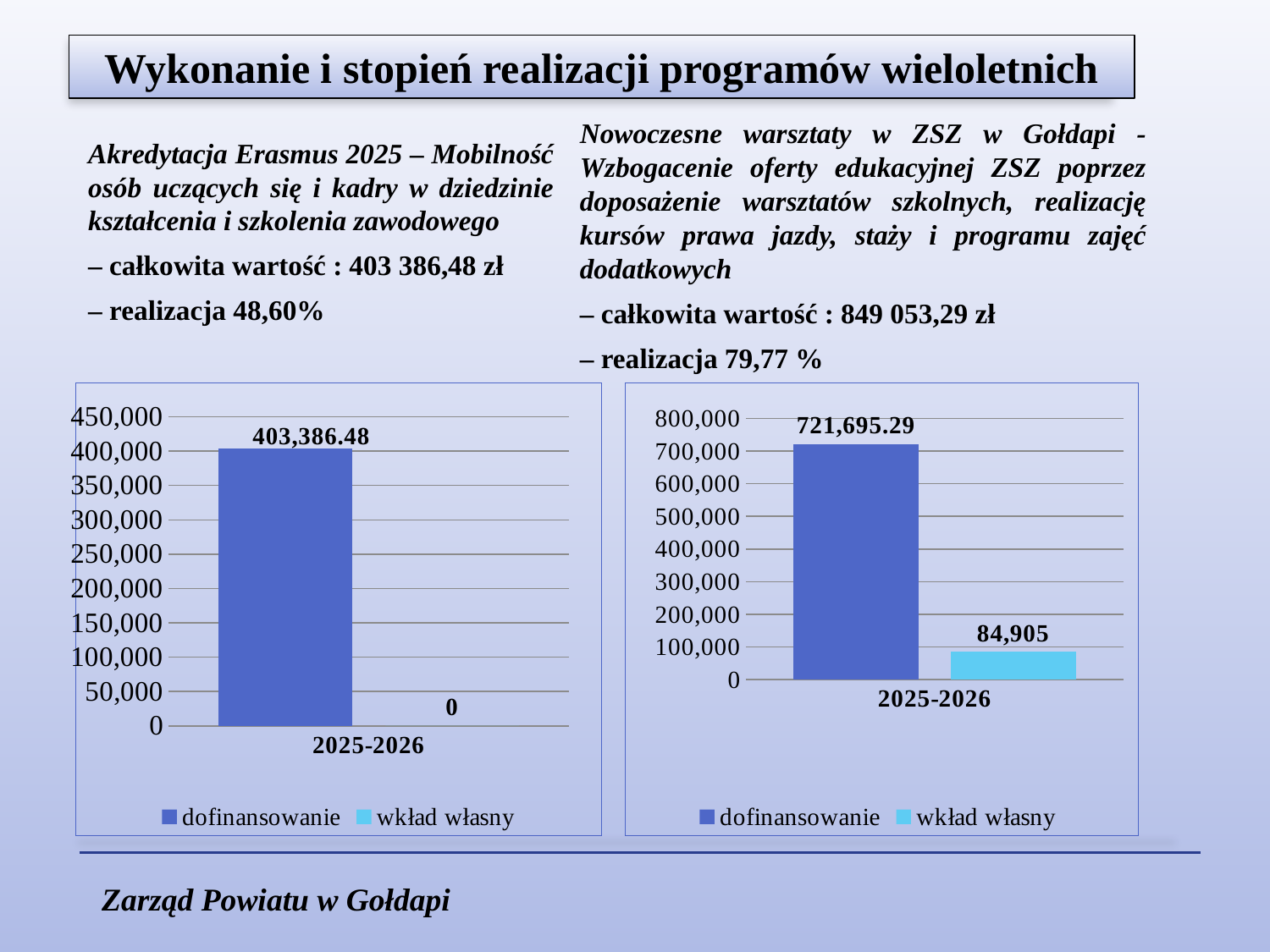
What kind of chart is the right chart? bar chart In the right chart, which series has the higher value: dofinansowanie or wkład własny? dofinansowanie How many series does the legend of the left chart list? 2 In the right chart, what is the value for wkład własny in 2025-2026? 84,905 What category label appears on the x axis of the left chart? 2025-2026 In the left chart, is the value for dofinansowanie greater or less than 350,000? greater In the left chart, what is the value for dofinansowanie in 2025-2026? 403,386.48 In the right chart, what is the value for dofinansowanie in 2025-2026? 721,695.29 In the left chart, what is the value for wkład własny in 2025-2026? 0 In the right chart, is the value for wkład własny greater or less than 100,000? less In the right chart, what is the difference between dofinansowanie and wkład własny? 636,790.29 In the right chart, what is the total of dofinansowanie and wkład własny for 2025-2026? 806,600.29